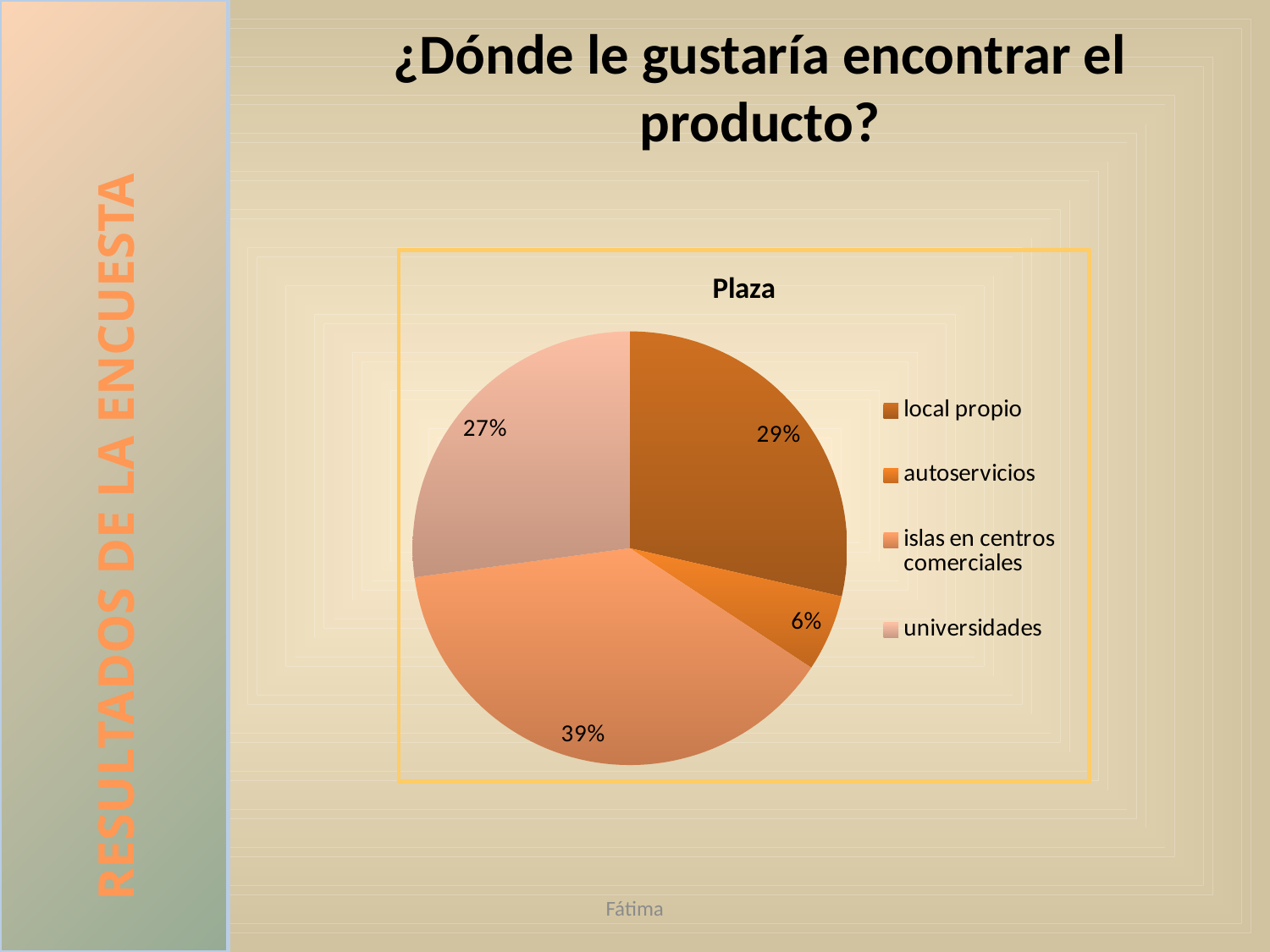
Which category has the smallest slice of the pie? autoservicios Which is larger, the share for 'local propio' or the share for 'universidades'? local propio What is the difference between the shares of 'islas en centros comerciales' and 'universidades'? 12% What share of the pie does 'autoservicios' have? 6% What share of the pie does 'universidades' have? 27% What share of the pie does 'local propio' have? 29% Which category has the largest slice of the pie? islas en centros comerciales What kind of chart is shown on the slide? pie chart How many entries does the legend list? 4 How many categories does the pie chart have? 4 What is the title of the chart? Plaza